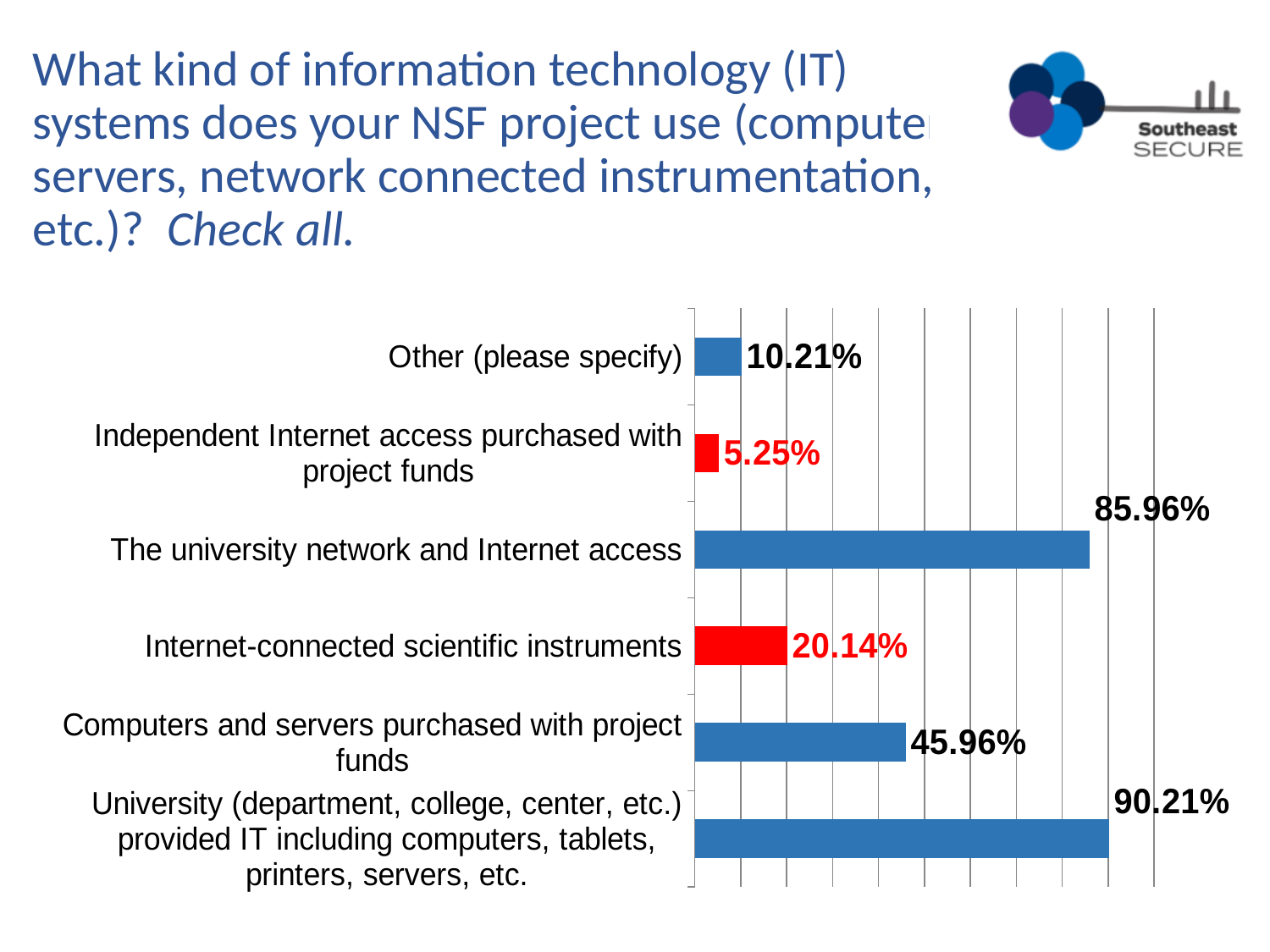
What is the value shown for "Internet-connected scientific instruments"? 20.14% What is the difference between the percentages for "University (department, college, center, etc.) provided IT" and "The university network and Internet access"? 4.25% What is the difference between the values for "Computers and servers purchased with project funds" and "Internet-connected scientific instruments"? 25.82% Which category has the lowest percentage? Independent Internet access purchased with project funds What is the value for "Computers and servers purchased with project funds"? 45.96% What percentage is shown for "Independent Internet access purchased with project funds"? 5.25% What percentage of respondents selected "The university network and Internet access"? 85.96% What kind of chart is shown on the slide? Bar chart Which two categories are shown with red bars? Independent Internet access purchased with project funds; Internet-connected scientific instruments Which is larger: the value for "Other (please specify)" or the value for "Internet-connected scientific instruments"? Internet-connected scientific instruments How many categories are shown in the chart? 6 Which category has the highest percentage? University (department, college, center, etc.) provided IT including computers, tablets, printers, servers, etc.